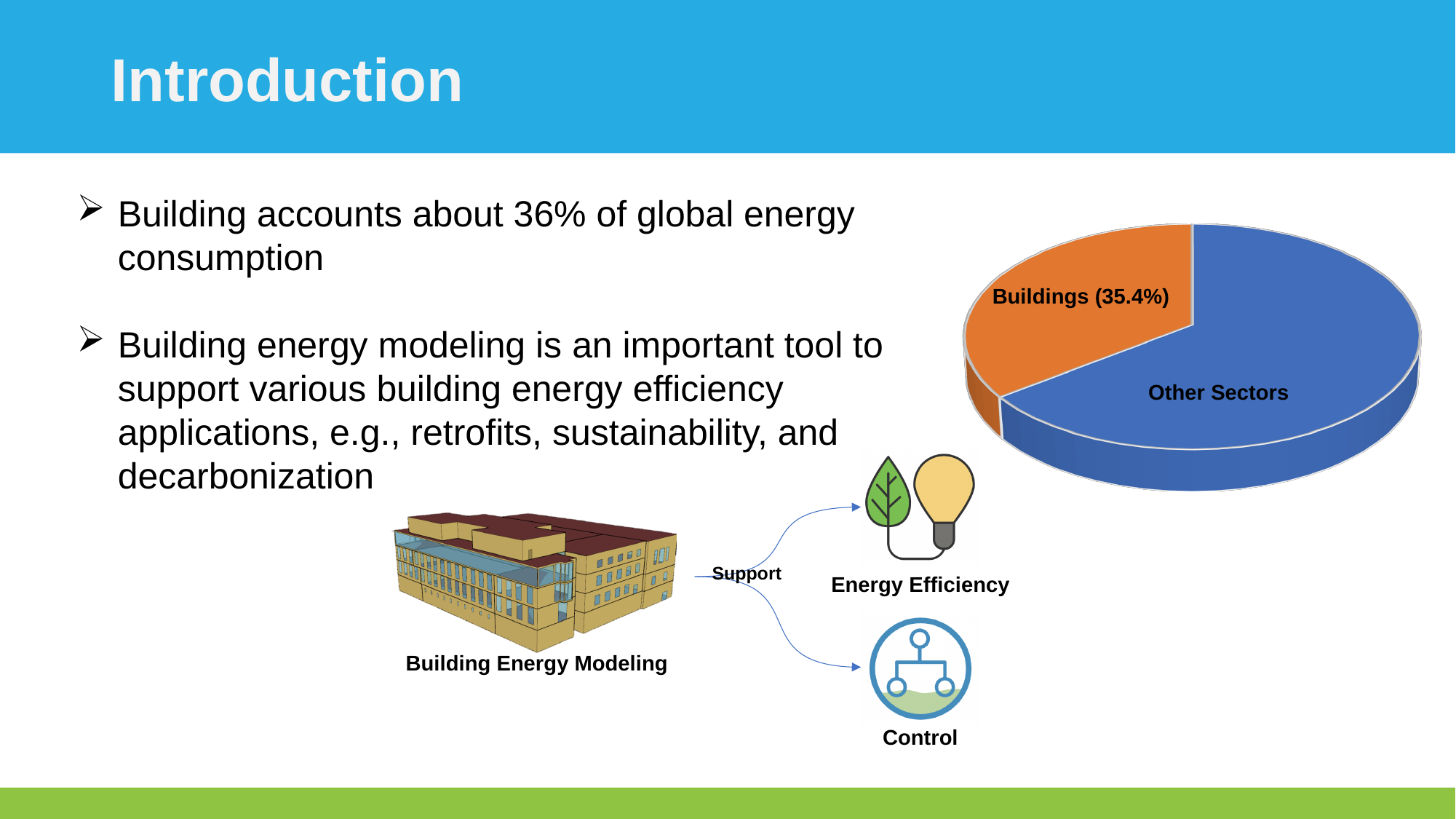
What colour is the Buildings slice in the pie chart? orange How many slices does the pie chart have? 2 What kind of chart is shown on the slide? pie chart What colour is the Other Sectors slice in the pie chart? blue What share of the pie chart is labelled for Buildings? 35.4% Which slice of the pie chart is the largest? Other Sectors In the pie chart, which is larger: Buildings or Other Sectors? Other Sectors Which slice of the pie chart is the smallest? Buildings